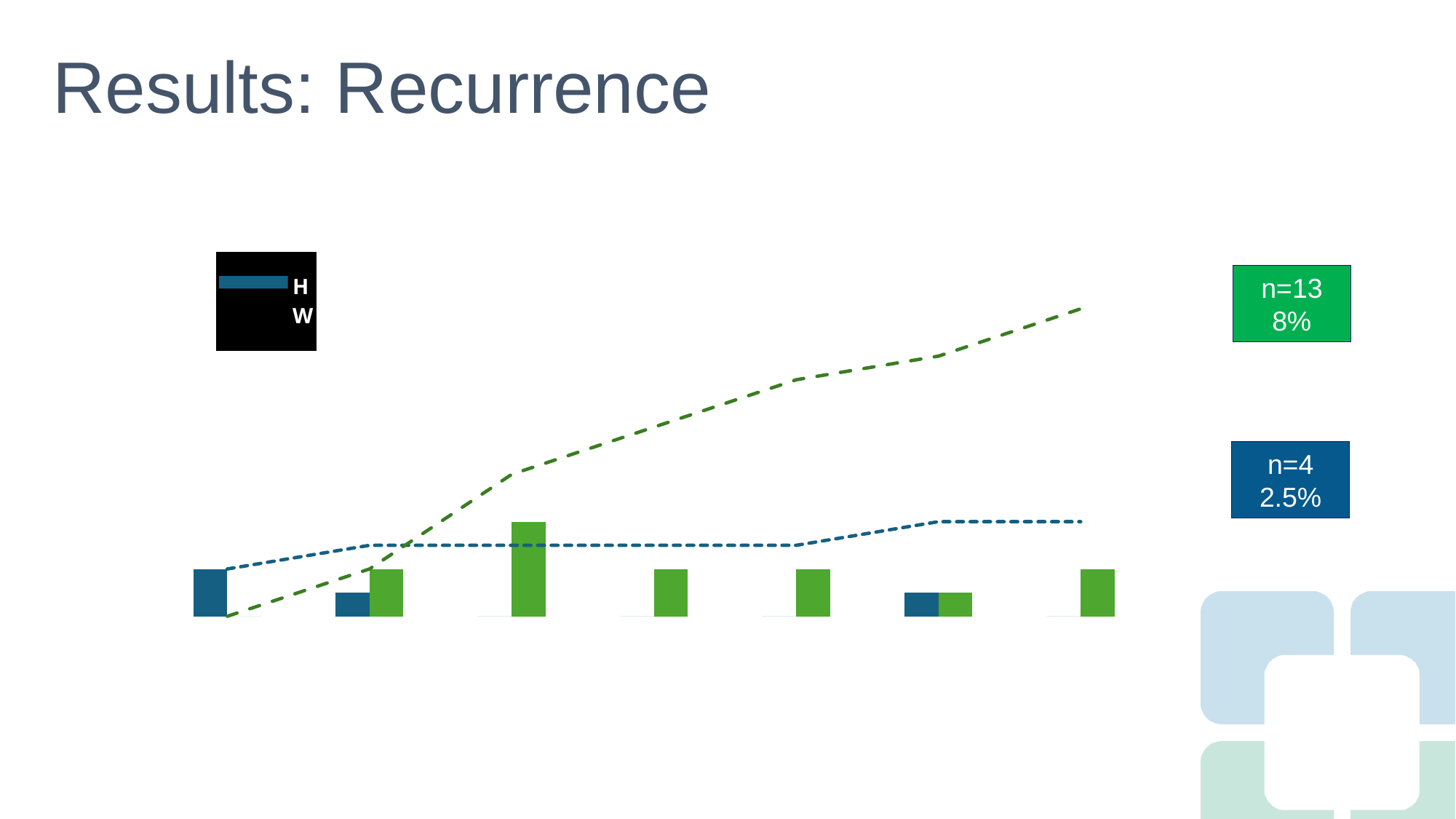
Which is taller, the green bar in the second group or the green bar in the third group? the green bar in the third group Does the green dashed line rise or fall from left to right? rise Which is taller, the blue bar in the first group or the blue bar in the second group? the blue bar in the first group What kind of chart is shown on the slide? bar chart (with dashed line series) Which bar is the tallest in the chart? the green bar in the third group from the left Which dashed line ends higher at the right side of the chart, the green one or the blue one? the green one What two colours are used for the bars in the chart? blue and green How many groups of bars are plotted along the x axis? 7 How many of the bar groups contain a blue bar? 3